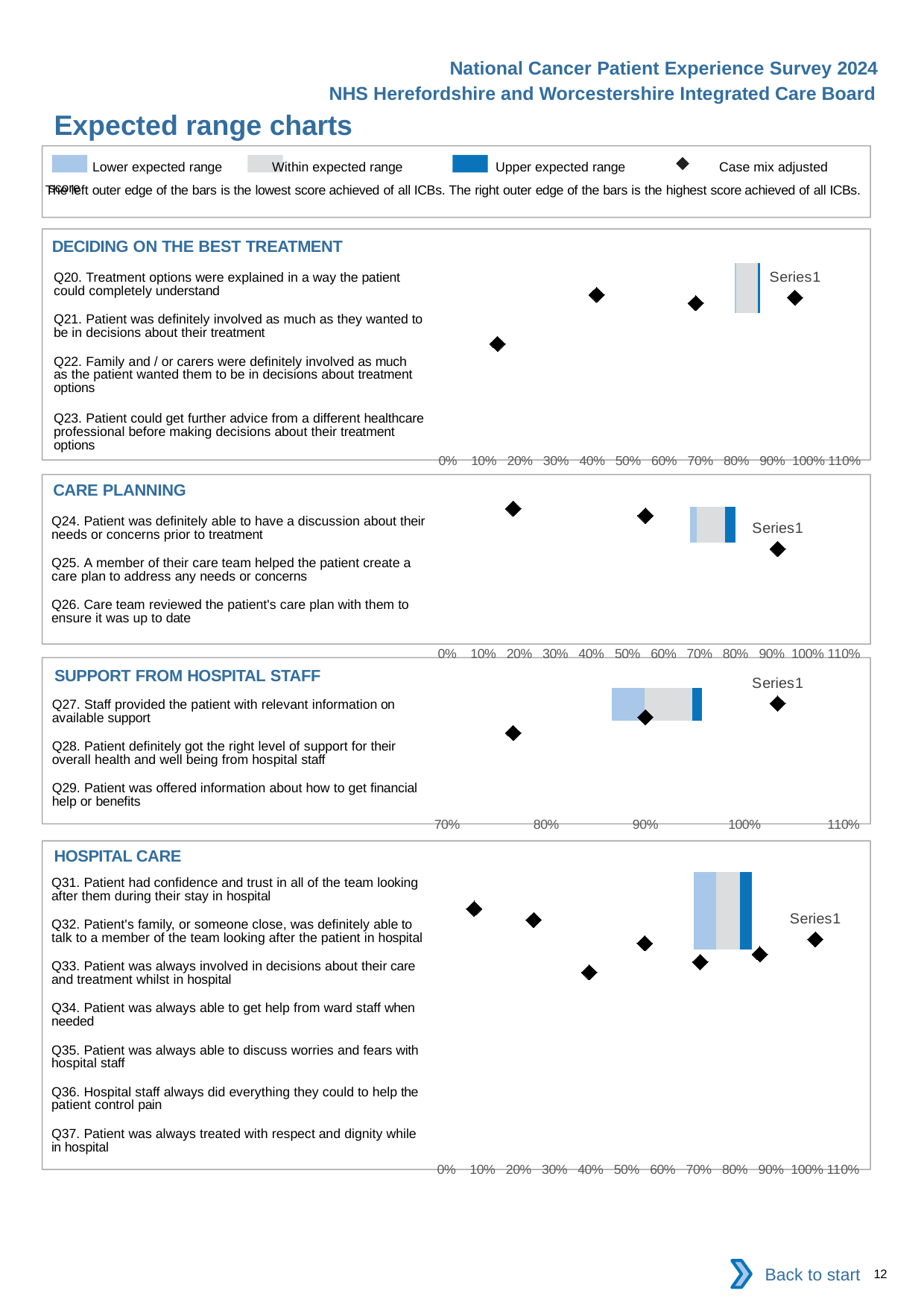
In the SUPPORT FROM HOSPITAL STAFF chart, are all the case mix adjusted score markers greater or less than 70%? greater In the DECIDING ON THE BEST TREATMENT chart, is the leftmost case mix adjusted score marker greater or less than 30%? less In the HOSPITAL CARE chart, is the leftmost case mix adjusted score marker greater or less than 20%? less How many entries does the legend at the top of the slide list? 4 What kind of chart is used in each section of the slide? bar chart In the CARE PLANNING chart, how many questions are listed? 3 In the HOSPITAL CARE chart, what is the highest value shown on the x axis? 110% In the SUPPORT FROM HOSPITAL STAFF chart, what is the lowest value shown on the x axis? 70% In the HOSPITAL CARE chart, how many questions are listed? 7 How many separate expected range charts are shown on the slide? 4